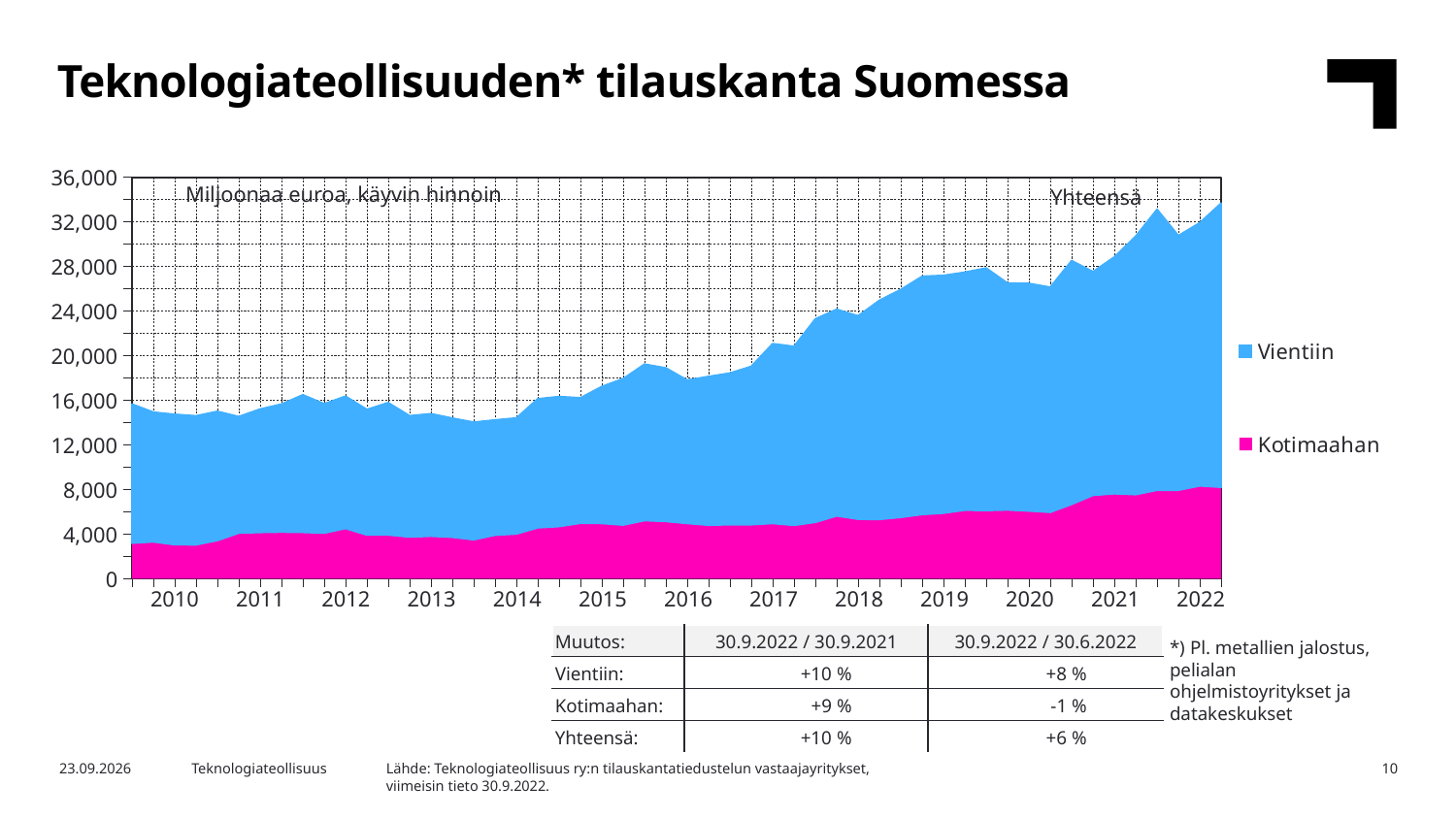
Which two series are listed in the chart legend? Vientiin and Kotimaahan In which year does the total (Yhteensä) reach its highest level on the chart? 2022 Is the total (Yhteensä) value at the start of 2014 greater or less than 16,000? less What kind of chart is shown on the slide? Stacked area chart Is the Kotimaahan value at the start of 2021 greater or less than 4,000? greater How many series does the chart legend list? 2 What unit is stated for the values in the chart? Miljoonaa euroa, käyvin hinnoin Is the Kotimaahan value at the start of 2010 greater or less than 4,000? less How many years are labelled on the x axis of the chart? 13 Does the total order book (Yhteensä) rise or fall overall from 2010 to 2022? Rise Which series is larger throughout the chart, Vientiin or Kotimaahan? Vientiin